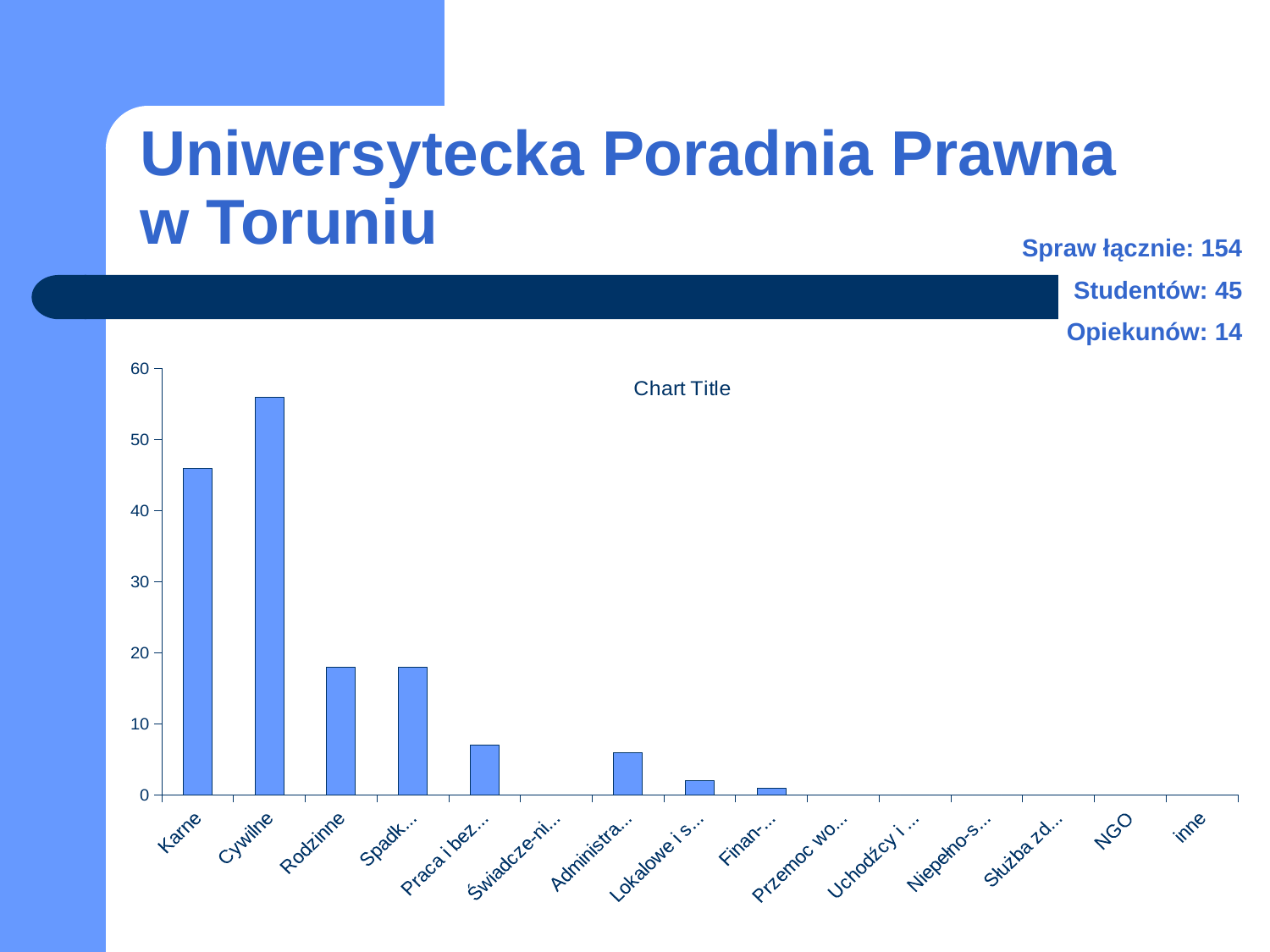
Is the value for Rodzinne greater or less than 20? less Which is larger, the value for Rodzinne or the value for Karne? Karne Is the value for Karne greater or less than 40? greater Which is larger, the value for Karne or the value for Cywilne? Cywilne Do the bar values generally rise or fall from left to right along the x axis? fall Which category has the highest bar in the chart? Cywilne Is the value for Karne greater or less than 50? less What is the title shown on the chart? Chart Title What kind of chart is shown on the slide? bar chart How many categories are shown on the x axis of the chart? 15